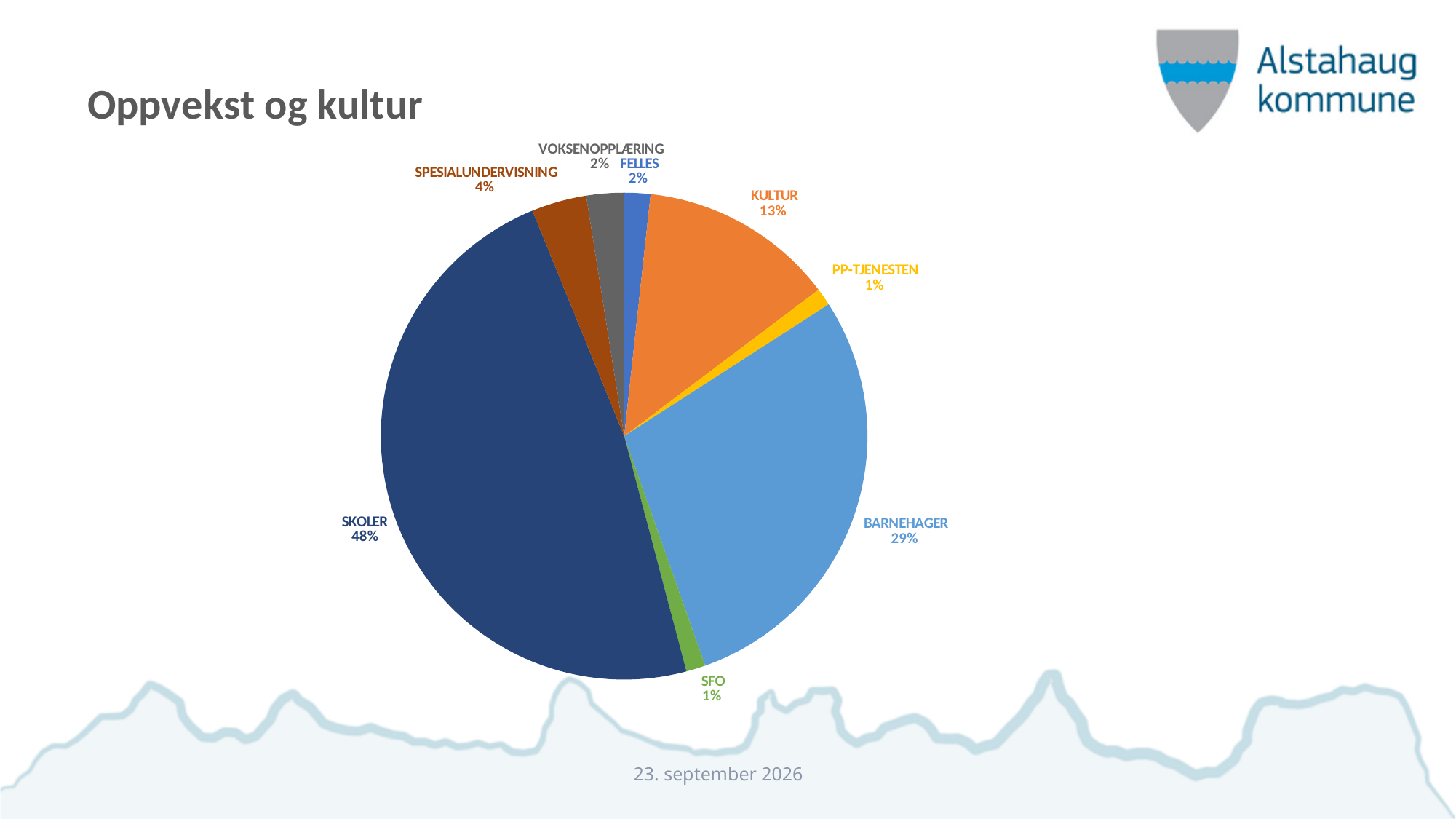
Which category has the largest slice of the pie? SKOLER What is the title of the slide containing the chart? Oppvekst og kultur What share of the pie does BARNEHAGER represent? 29% Which is larger, KULTUR or SPESIALUNDERVISNING? KULTUR What kind of chart is shown on the slide? Pie chart What share of the pie does KULTUR represent? 13% What share of the pie does FELLES represent? 2% What share of the pie does SKOLER represent? 48% How many categories are shown in the pie chart? 8 What colour is the SFO slice? Green What share of the pie does SPESIALUNDERVISNING represent? 4% What is the difference in percentage points between SKOLER and BARNEHAGER? 19